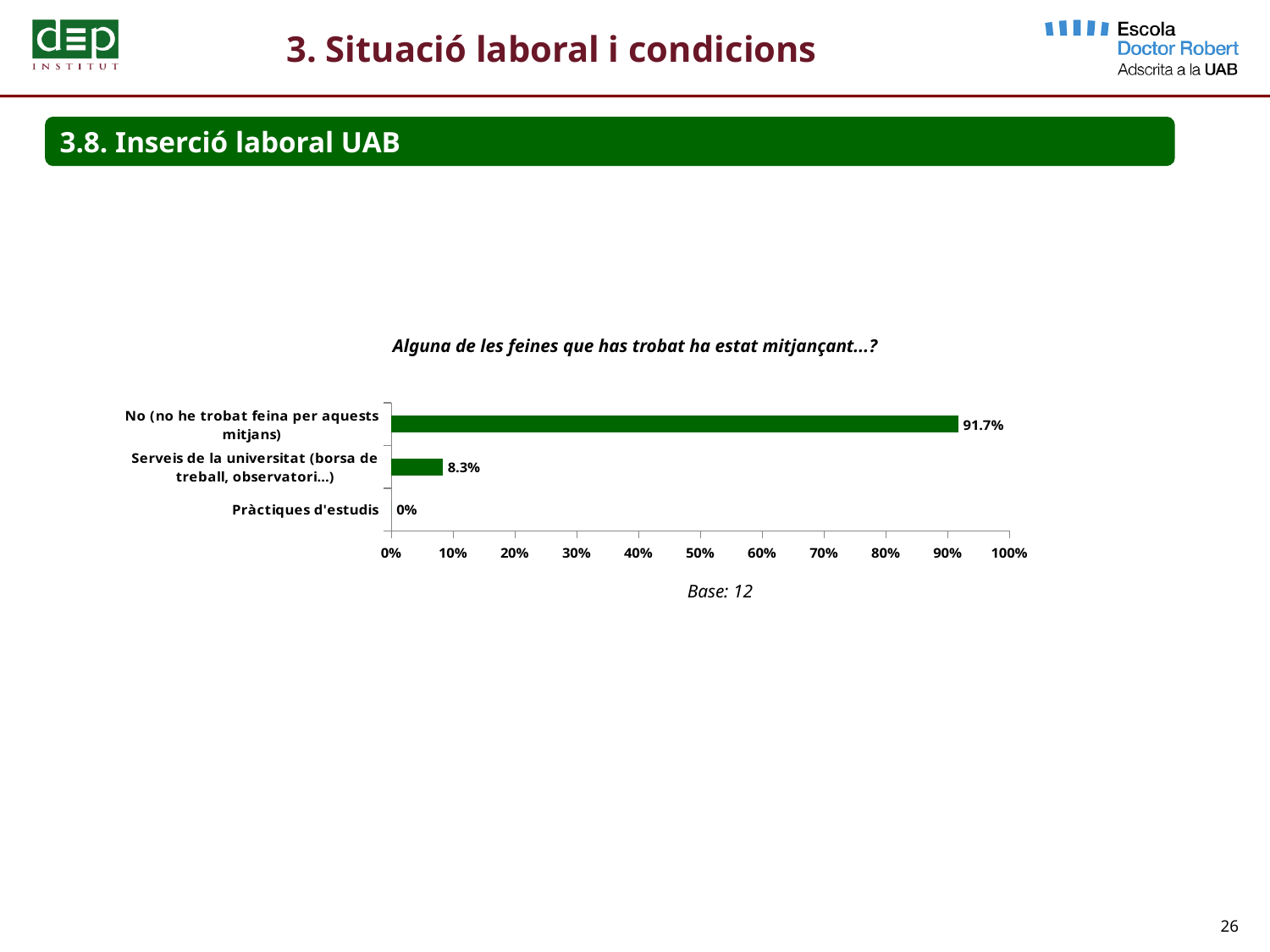
What is the value for "No (no he trobat feina per aquests mitjans)"? 91.7% Which category has the highest value? No (no he trobat feina per aquests mitjans) What is the base (number of respondents) stated below the chart? 12 What is the value for "Serveis de la universitat (borsa de treball, observatori...)"? 8.3% What is the difference between the values for "No (no he trobat feina per aquests mitjans)" and "Serveis de la universitat (borsa de treball, observatori...)"? 83.4% Which category has the lowest value? Pràctiques d'estudis How many categories are shown in the chart? 3 Which is larger: the value for "Serveis de la universitat (borsa de treball, observatori...)" or for "Pràctiques d'estudis"? Serveis de la universitat (borsa de treball, observatori...) What kind of chart is shown on the slide? Bar chart Is the value for "Serveis de la universitat (borsa de treball, observatori...)" greater or less than 10%? less What is the value for "Pràctiques d'estudis"? 0% Is the value for "No (no he trobat feina per aquests mitjans)" greater or less than 90%? greater